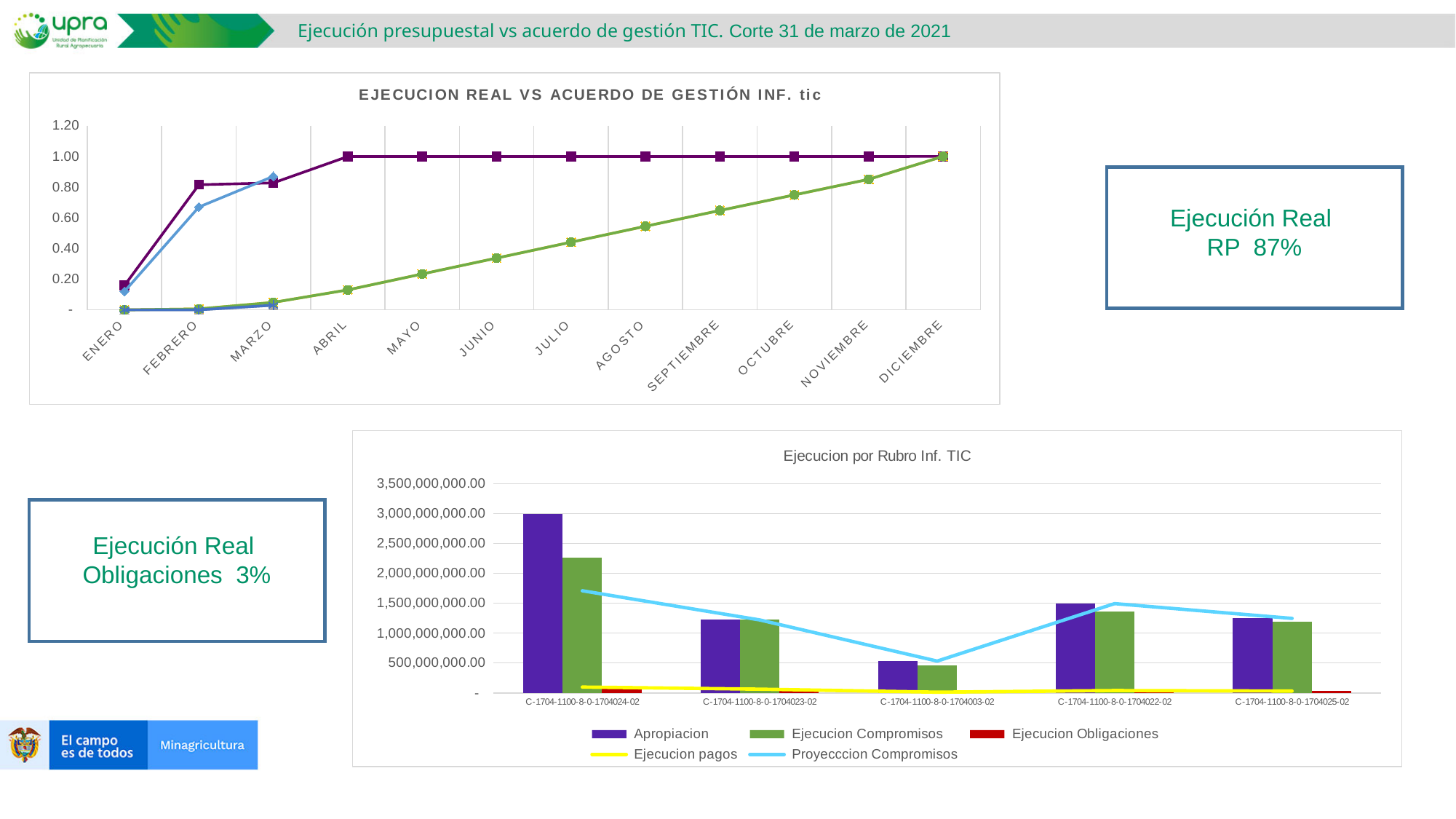
In the bottom chart 'Ejecucion por Rubro Inf. TIC', which has the larger Apropiacion value: C-1704-1100-8-0-1704022-02 or C-1704-1100-8-0-1704025-02? C-1704-1100-8-0-1704022-02 In the top chart 'EJECUCION REAL VS ACUERDO DE GESTIÓN INF. tic', is the value of the purple line for FEBRERO greater or less than 0.60? greater In the bottom chart 'Ejecucion por Rubro Inf. TIC', is the Ejecucion Compromisos value for C-1704-1100-8-0-1704024-02 greater or less than 2,000,000,000.00? greater In the bottom chart 'Ejecucion por Rubro Inf. TIC', which category has the lowest Apropiacion value? C-1704-1100-8-0-1704003-02 How many categories are shown on the x axis of the bottom chart 'Ejecucion por Rubro Inf. TIC'? 5 In the top chart 'EJECUCION REAL VS ACUERDO DE GESTIÓN INF. tic', does the green line rise or fall from ENERO to DICIEMBRE? rises In the top chart 'EJECUCION REAL VS ACUERDO DE GESTIÓN INF. tic', is the value of the green line for JUNIO greater or less than 0.40? less How many months are shown on the x axis of the top chart 'EJECUCION REAL VS ACUERDO DE GESTIÓN INF. tic'? 12 What is the title of the bottom chart? Ejecucion por Rubro Inf. TIC What type of chart is the top chart titled 'EJECUCION REAL VS ACUERDO DE GESTIÓN INF. tic'? line chart How many series does the legend of the bottom chart 'Ejecucion por Rubro Inf. TIC' list? 5 In the bottom chart 'Ejecucion por Rubro Inf. TIC', which category has the highest Apropiacion value? C-1704-1100-8-0-1704024-02